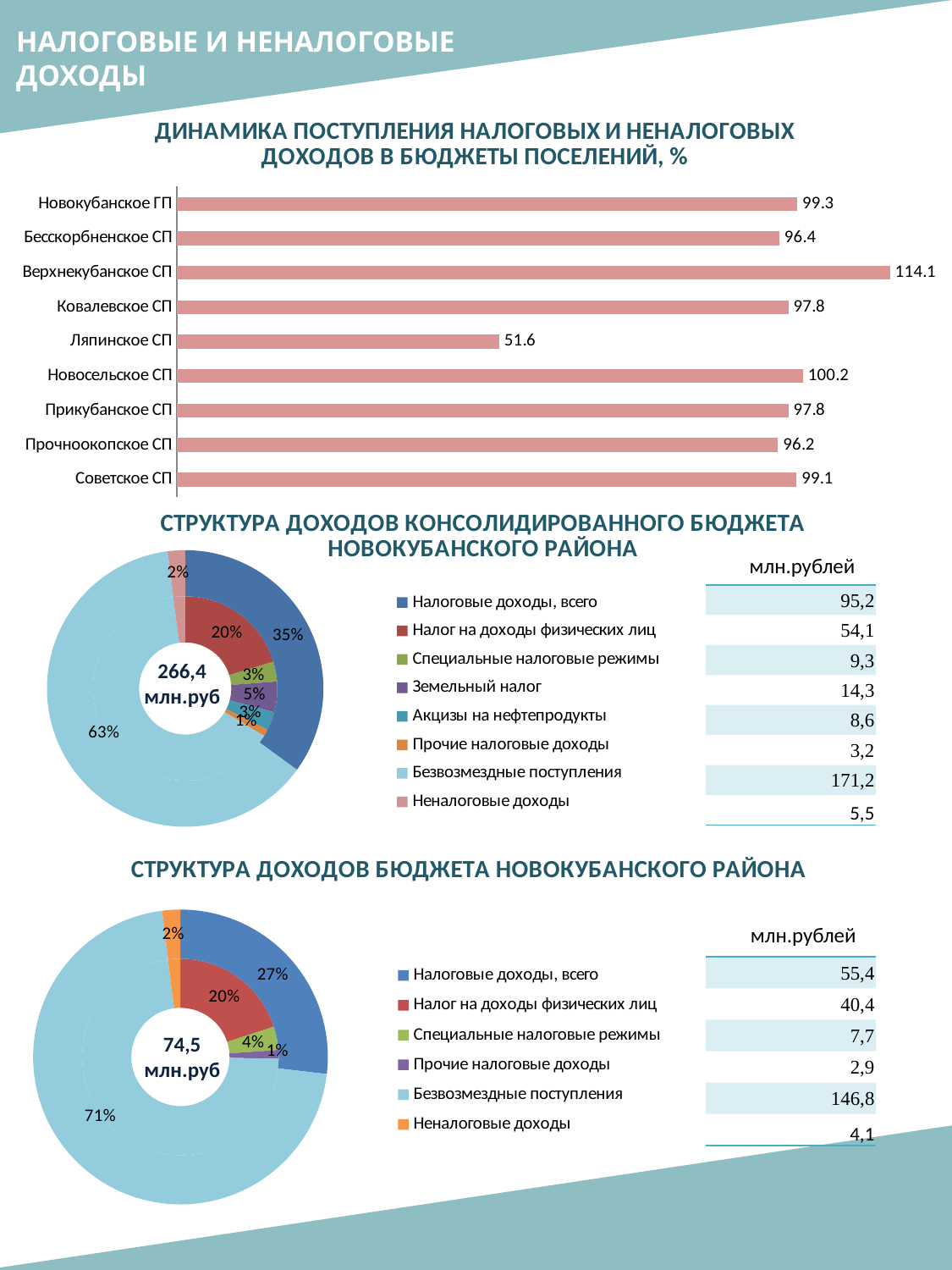
In the top bar chart, which settlement has the lowest value? Ляпинское СП In the middle chart's table, what is the value in млн.рублей for Земельный налог? 14,3 In the middle doughnut chart, how many entries does the legend list? 8 In the top bar chart, which is larger: the value for Бесскорбненское СП or Прочноокопское СП? Бесскорбненское СП In the top bar chart, what is the difference between the values for Новокубанское ГП and Советское СП? 0.2 In the top bar chart, which settlement has the highest value? Верхнекубанское СП In the middle doughnut chart 'Структура доходов консолидированного бюджета Новокубанского района', what share is Безвозмездные поступления? 63% In the top bar chart 'Динамика поступления налоговых и неналоговых доходов в бюджеты поселений, %', what is the value for Ляпинское СП? 51.6 What type of chart is the top chart on the slide? Bar chart In the bottom doughnut chart 'Структура доходов бюджета Новокубанского района', what share is Налоговые доходы, всего? 27% In the top bar chart, how many settlements are shown? 9 What total is shown in the centre of the bottom doughnut chart? 74,5 млн.руб